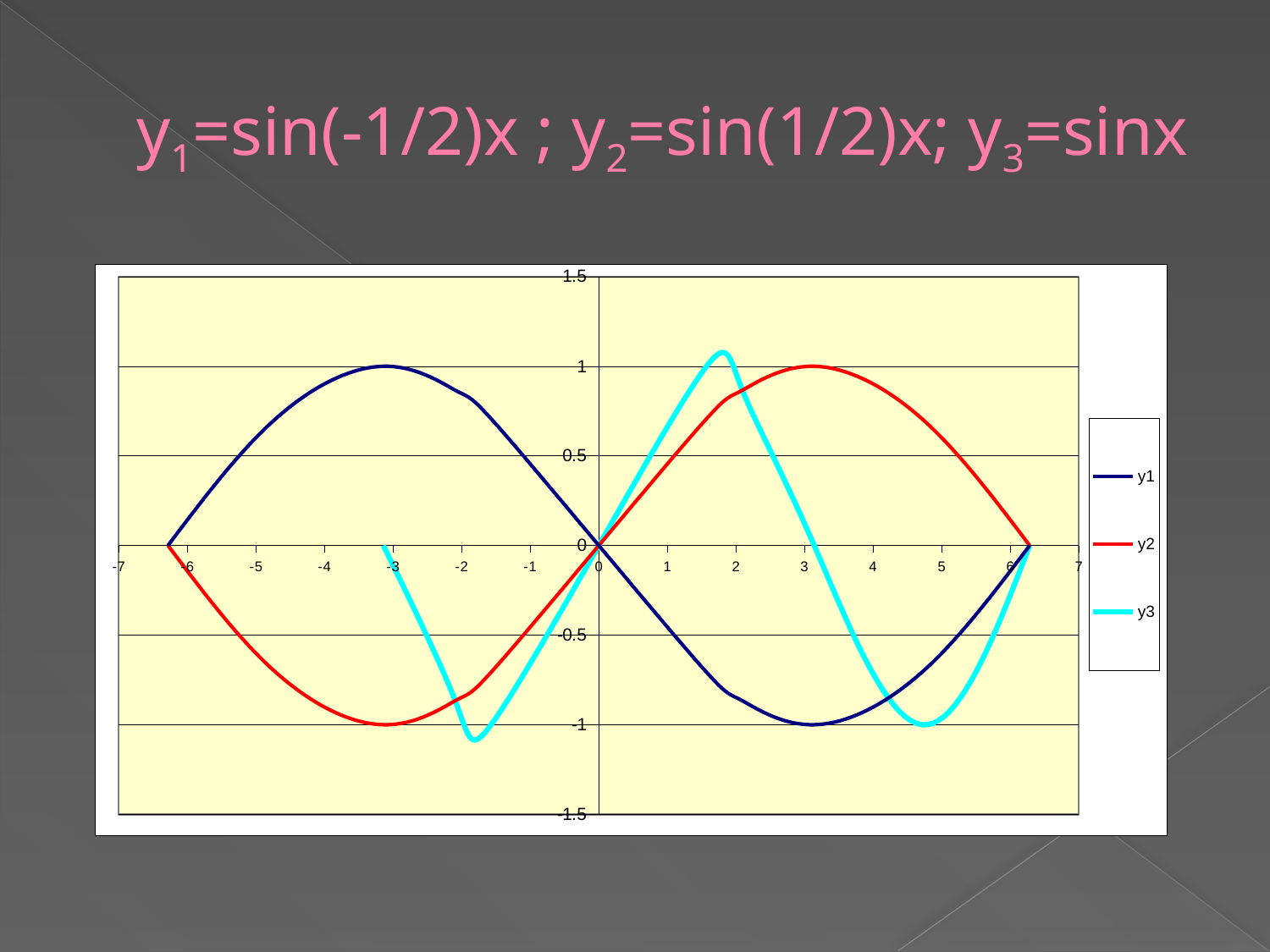
What kind of chart is shown on the slide? Line chart At x = -3, which series has the larger value, y1 or y2? y1 How many series does the legend list? 3 What are the series names listed in the legend? y1, y2, y3 Is the value of y3 at x = 2 greater or less than 0.5? greater Is the value of y1 at x = 3 greater or less than -0.5? less What is the value of y1 at x = 0? 0 At x = 3, which series has the larger value, y1 or y2? y2 Is the value of y2 at x = 3 greater or less than 0.5? greater Does the y2 line rise or fall as x goes from 0 to 3? Rise What colour is the line for series y3? Cyan